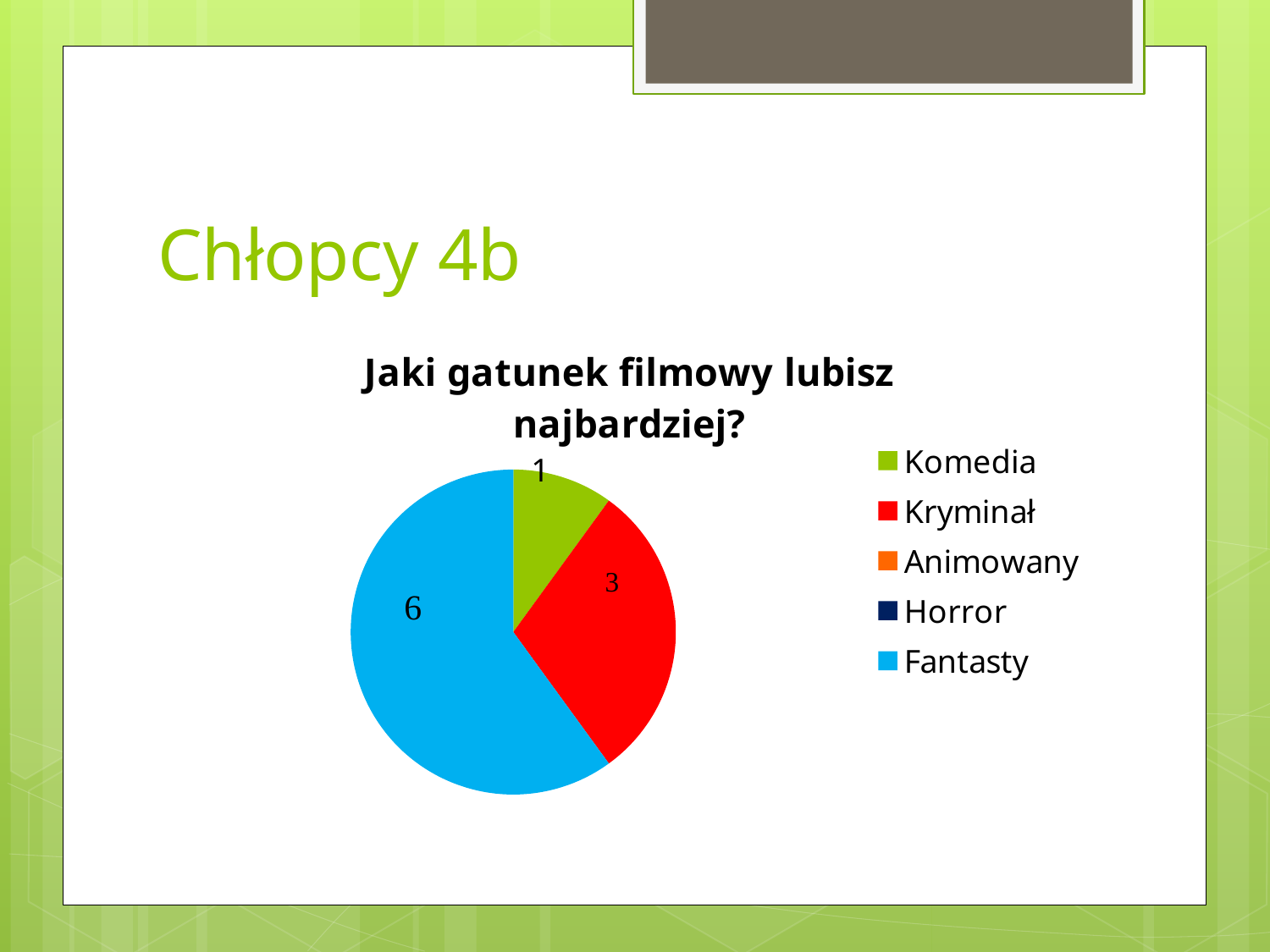
Which is larger, the value for Kryminał or the value for Komedia? Kryminał What is the value for Komedia in the pie chart? 1 Which category has the largest slice of the pie chart? Fantasty What is the total of the labelled values in the pie chart? 10 What is the value for Fantasty in the pie chart? 6 What is the title of the pie chart? Jaki gatunek filmowy lubisz najbardziej? What type of chart is shown on the slide? pie chart How many entries does the legend of the pie chart list? 5 What is the value for Kryminał in the pie chart? 3 Which of the labelled slices is the smallest in the pie chart? Komedia What is the difference between the values for Fantasty and Kryminał? 3 What share of the pie does Fantasty represent? 60%